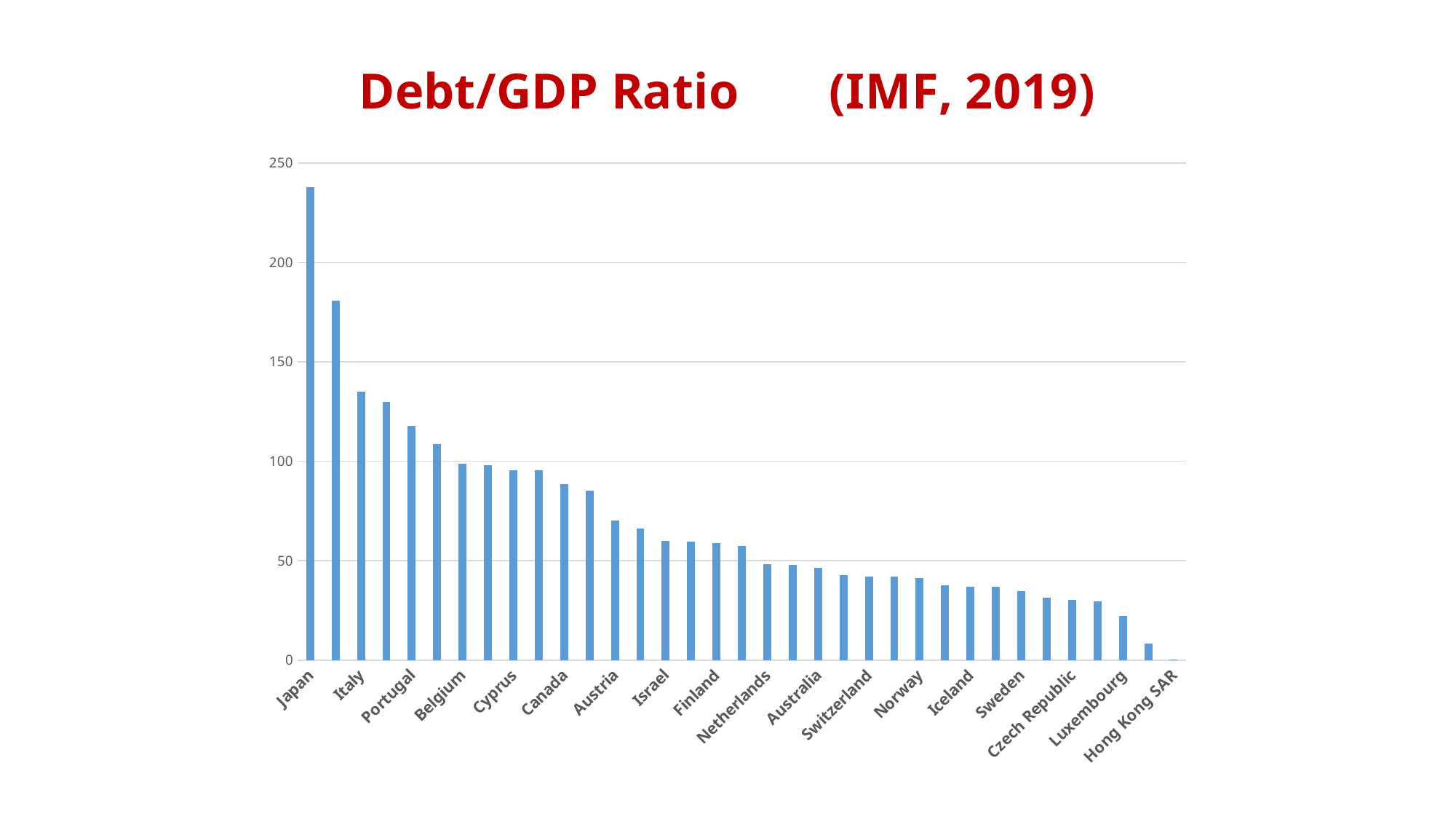
Which has a higher Debt/GDP ratio, Italy or Portugal? Italy Which labelled country has the lowest Debt/GDP ratio in the chart? Hong Kong SAR Is the Debt/GDP ratio for Italy greater or less than 100? greater Is the Debt/GDP ratio for Canada greater or less than 100? less Is the Debt/GDP ratio for Japan greater or less than 200? greater Which country has the highest Debt/GDP ratio in the chart? Japan Do the values rise or fall moving from left to right along the x axis? Fall Which has a higher Debt/GDP ratio, Switzerland or Canada? Canada What is the title of the chart? Debt/GDP Ratio (IMF, 2019) What kind of chart is shown on the slide? Bar chart